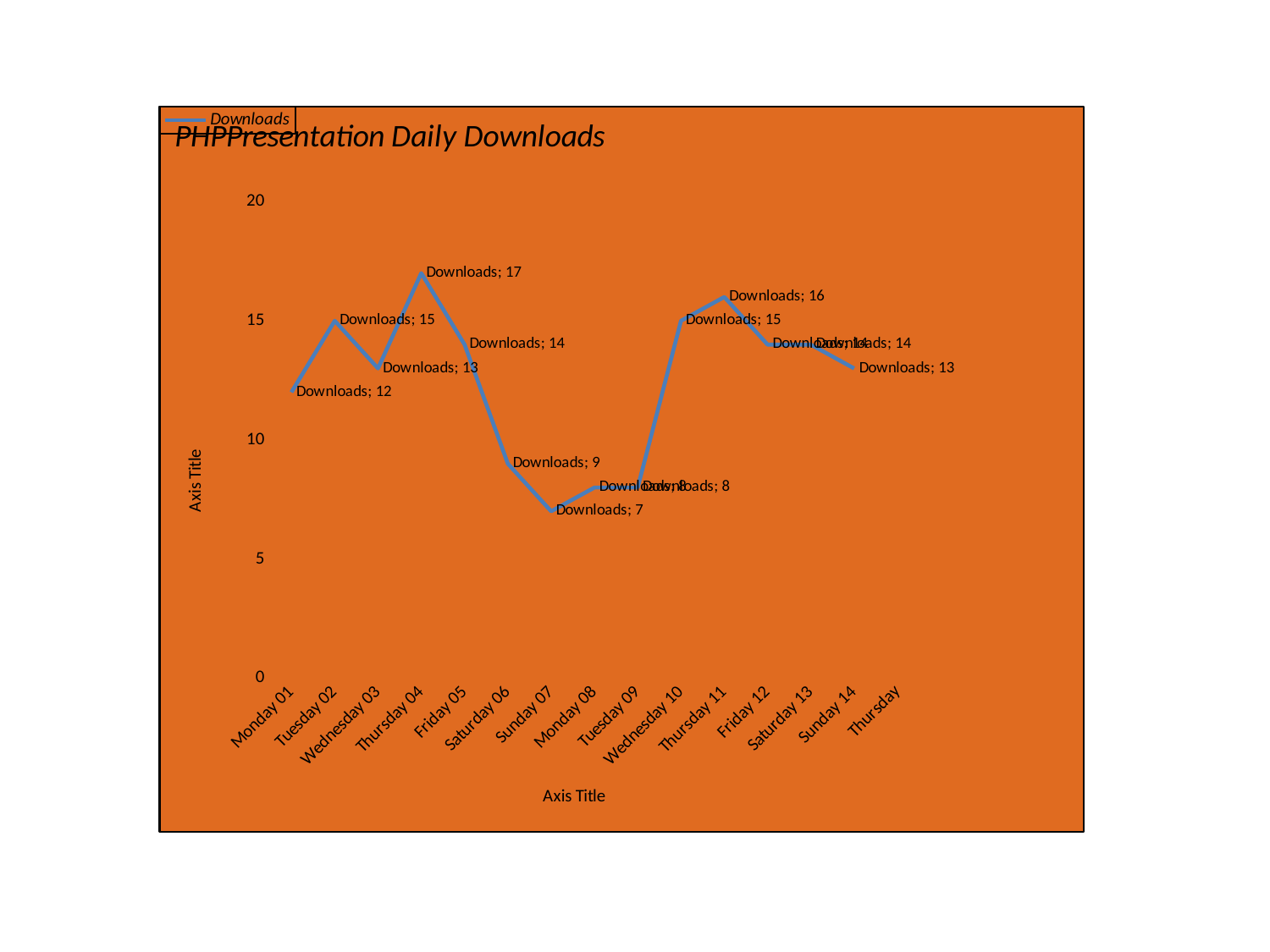
What is the Downloads value for Thursday 11? 16 Which day has the lowest Downloads value? Sunday 07 What kind of chart is shown on the slide? line chart What is the Downloads value for Sunday 07? 7 How many series does the legend list? 1 Is the Downloads value for Saturday 06 greater or less than 10? less What is the title of the chart? PHPPresentation Daily Downloads What is the Downloads value for Monday 01? 12 Which has a higher Downloads value, Tuesday 02 or Wednesday 03? Tuesday 02 What is the difference between the Downloads values for Thursday 04 and Sunday 07? 10 What is the Downloads value for Thursday 04? 17 Which day has the highest Downloads value? Thursday 04